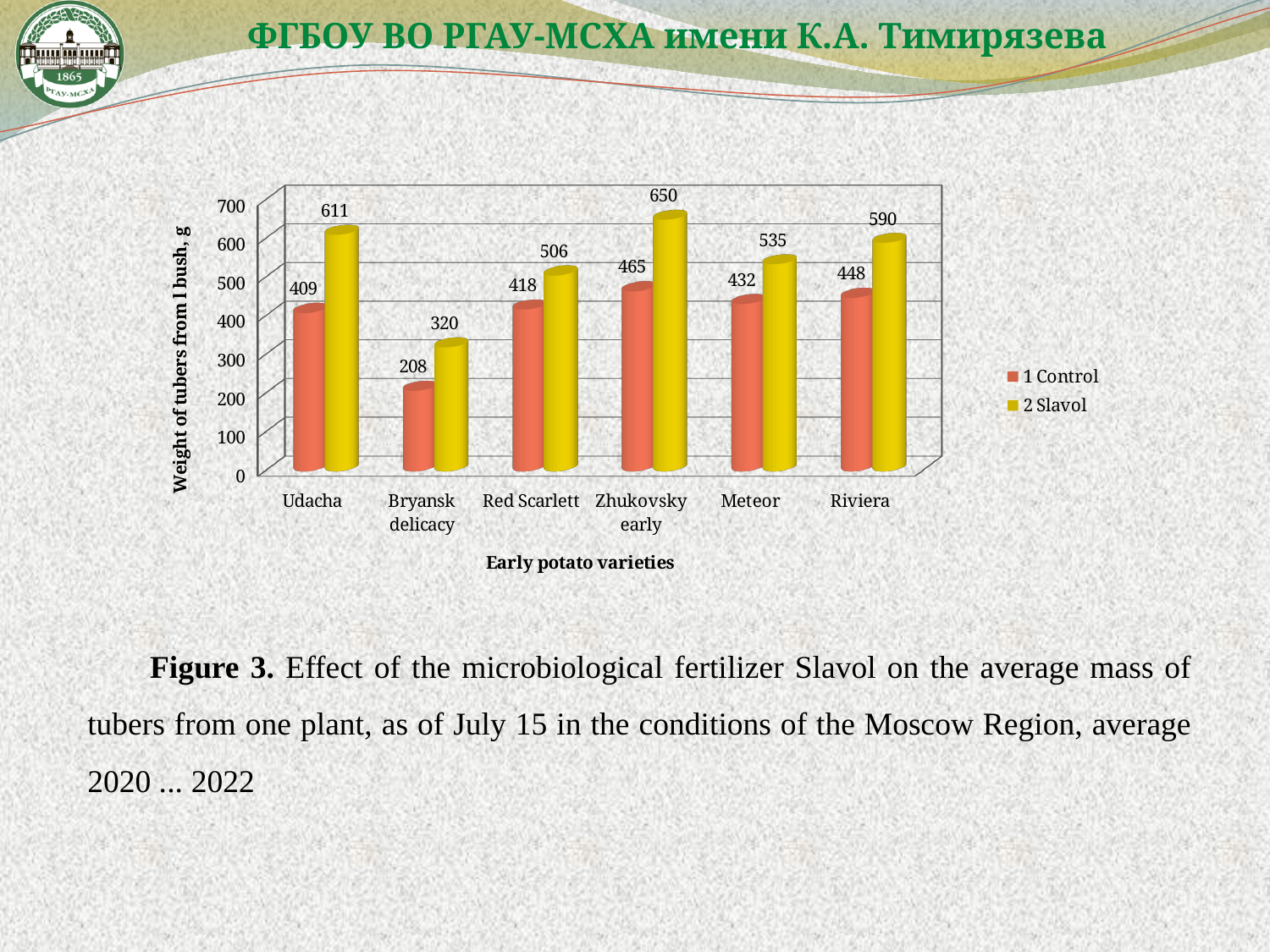
What is the Control value for Udacha? 409 How many potato varieties are shown on the x axis? 6 What is the Slavol value for Zhukovsky early? 650 How many series does the legend list? 2 What is the Control value for Bryansk delicacy? 208 What colour are the Slavol bars? Yellow What is the difference between the Slavol and Control values for Riviera? 142 Which variety has the lowest Control value? Bryansk delicacy What is the y-axis label of the chart? Weight of tubers from 1 bush, g What kind of chart is shown? Bar chart Which variety has the highest Slavol value? Zhukovsky early Which is larger, the Slavol value for Udacha or the Slavol value for Meteor? Udacha